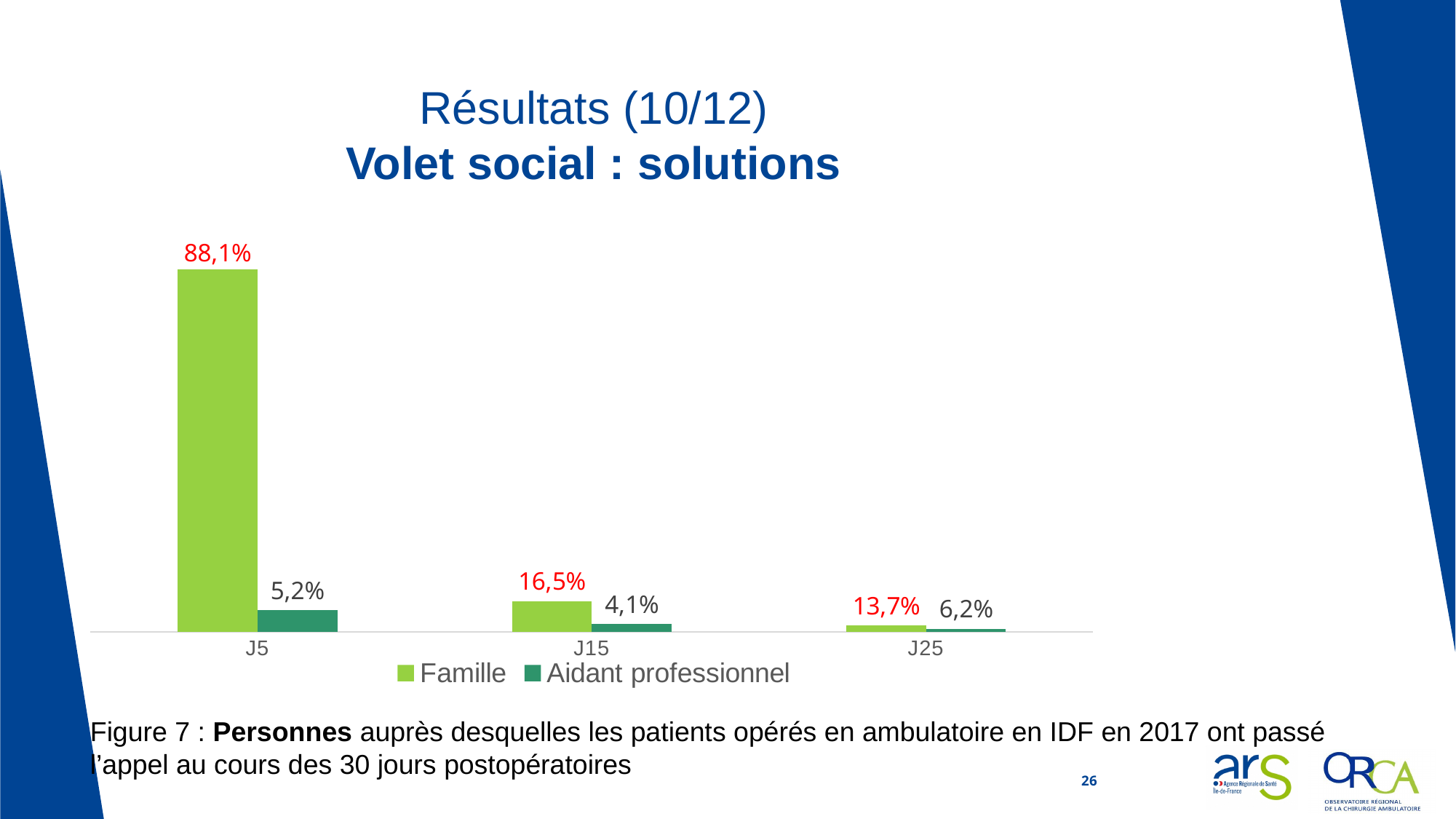
Does the Famille value rise or fall from J5 to J25? Fall How many time points are shown on the x axis? 3 Which is larger at J25: Famille or Aidant professionnel? Famille How many series does the legend list? 2 What is the value for Aidant professionnel at J25? 6,2% At which time point is the Famille value highest? J5 What is the difference between the Famille and Aidant professionnel values at J5? 82,9% What kind of chart is shown on the slide? Bar chart What is the value for Aidant professionnel at J15? 4,1% What is the value for Famille at J5? 88,1% What is the value for Famille at J25? 13,7%